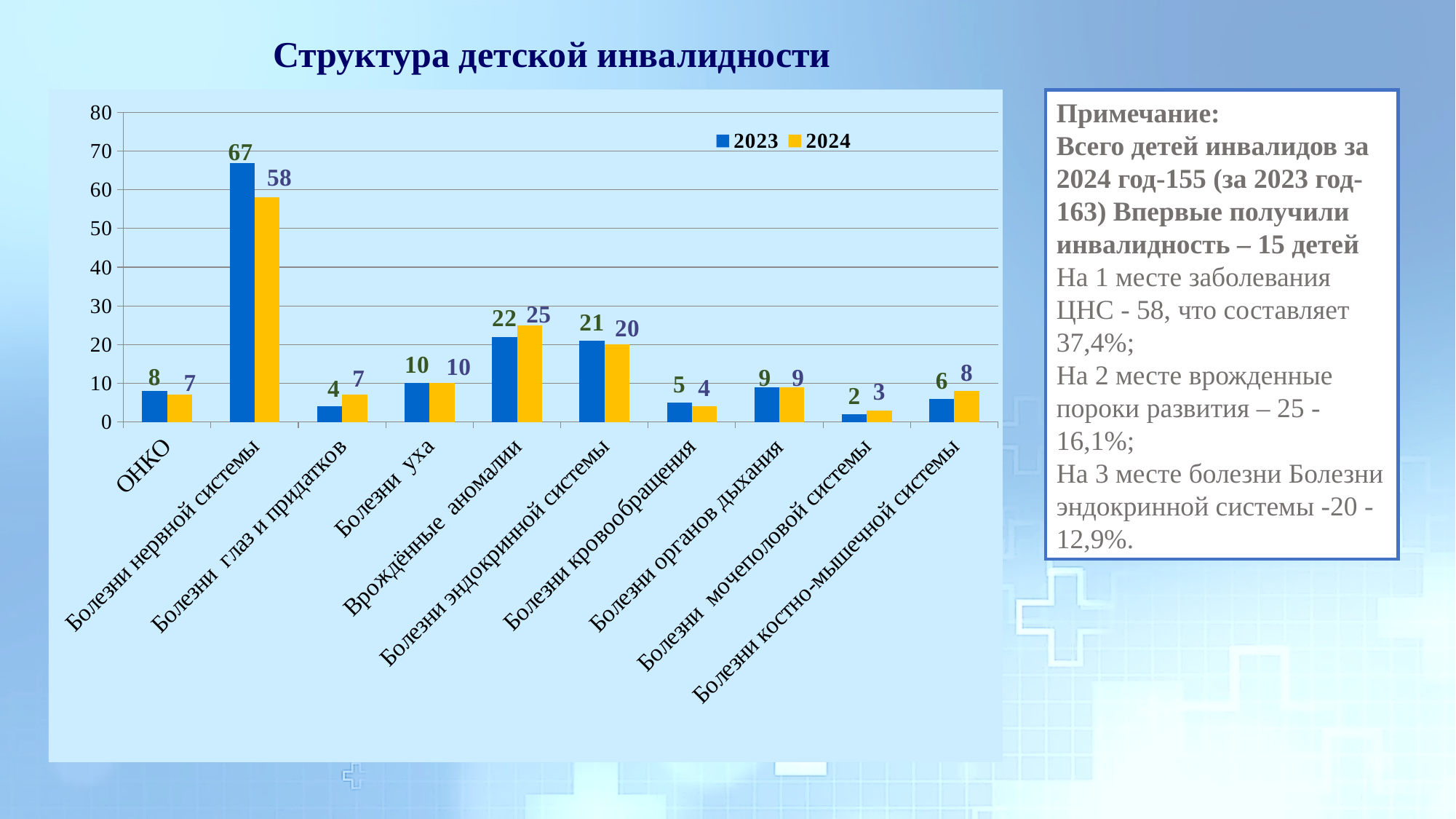
Which category has the highest 2024 value? Болезни нервной системы What is the 2024 value for Врождённые аномалии? 25 What is the title of the slide? Структура детской инвалидности Which category has the lowest 2023 value? Болезни мочеполовой системы What is the difference between the 2023 and 2024 values for Болезни нервной системы? 9 What is the total of the 2023 and 2024 values for Болезни костно-мышечной системы? 14 What is the 2024 value for Болезни мочеполовой системы? 3 What kind of chart is shown on the slide? bar chart How many categories are shown on the x axis? 10 How many series does the legend list? 2 Which is larger for Болезни глаз и придатков: the 2023 value or the 2024 value? 2024 What is the 2023 value for Болезни нервной системы? 67